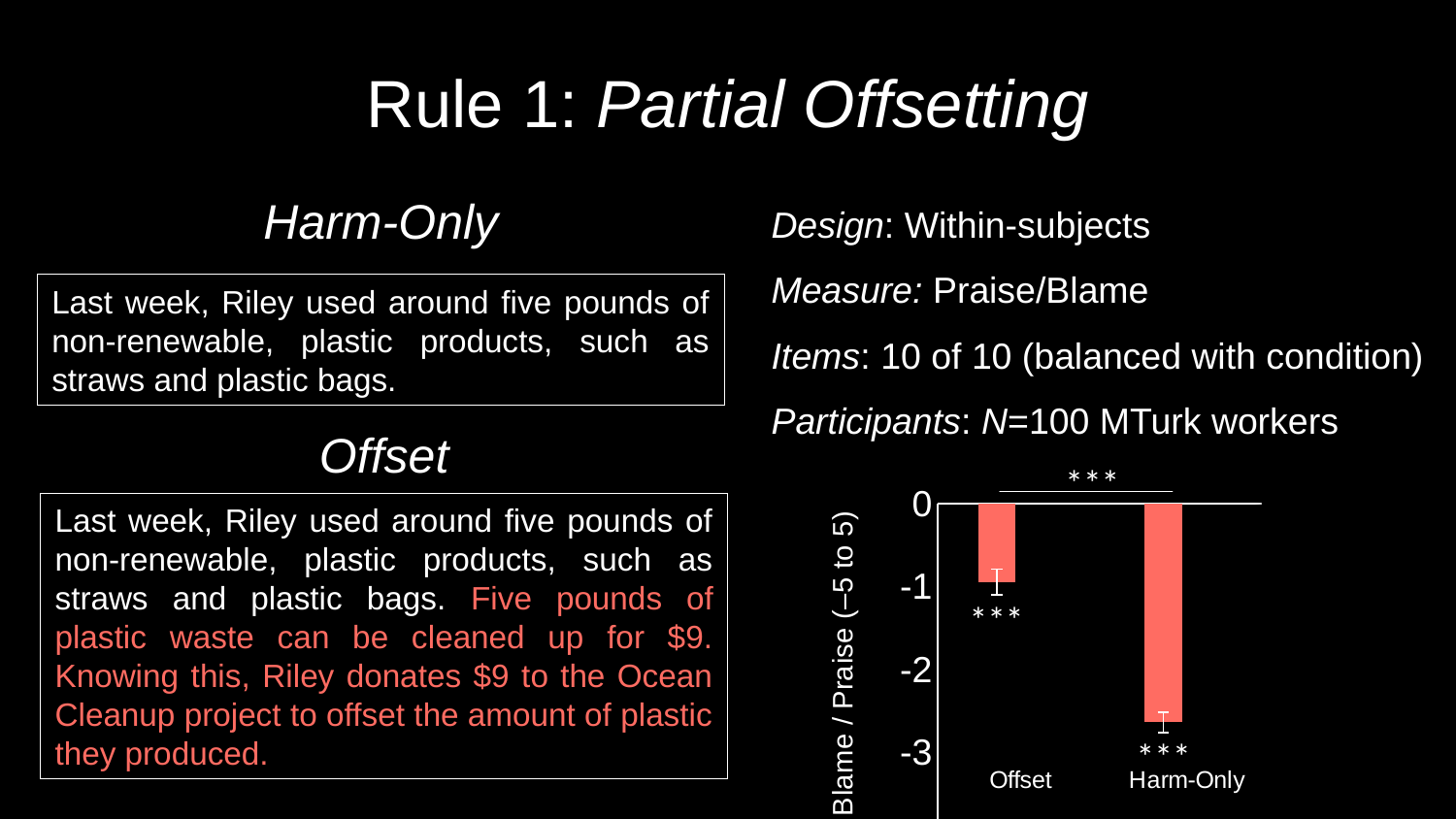
Which category has the lowest (most negative) value in the chart? Harm-Only Do the values fall or rise going from Offset to Harm-Only along the x axis? fall Which category has the highest value in the chart? Offset Is the value for Offset greater or less than -2? greater How many categories are plotted on the x axis of the chart? 2 Is the value for Harm-Only greater or less than -3? greater Is the value for Harm-Only greater or less than -2? less What kind of chart is shown on the slide? bar chart Which of the two bars, Offset or Harm-Only, has the larger value? Offset What is the label of the y axis of the chart? Blame / Praise (-5 to 5) Are the values in the chart positive or negative? negative